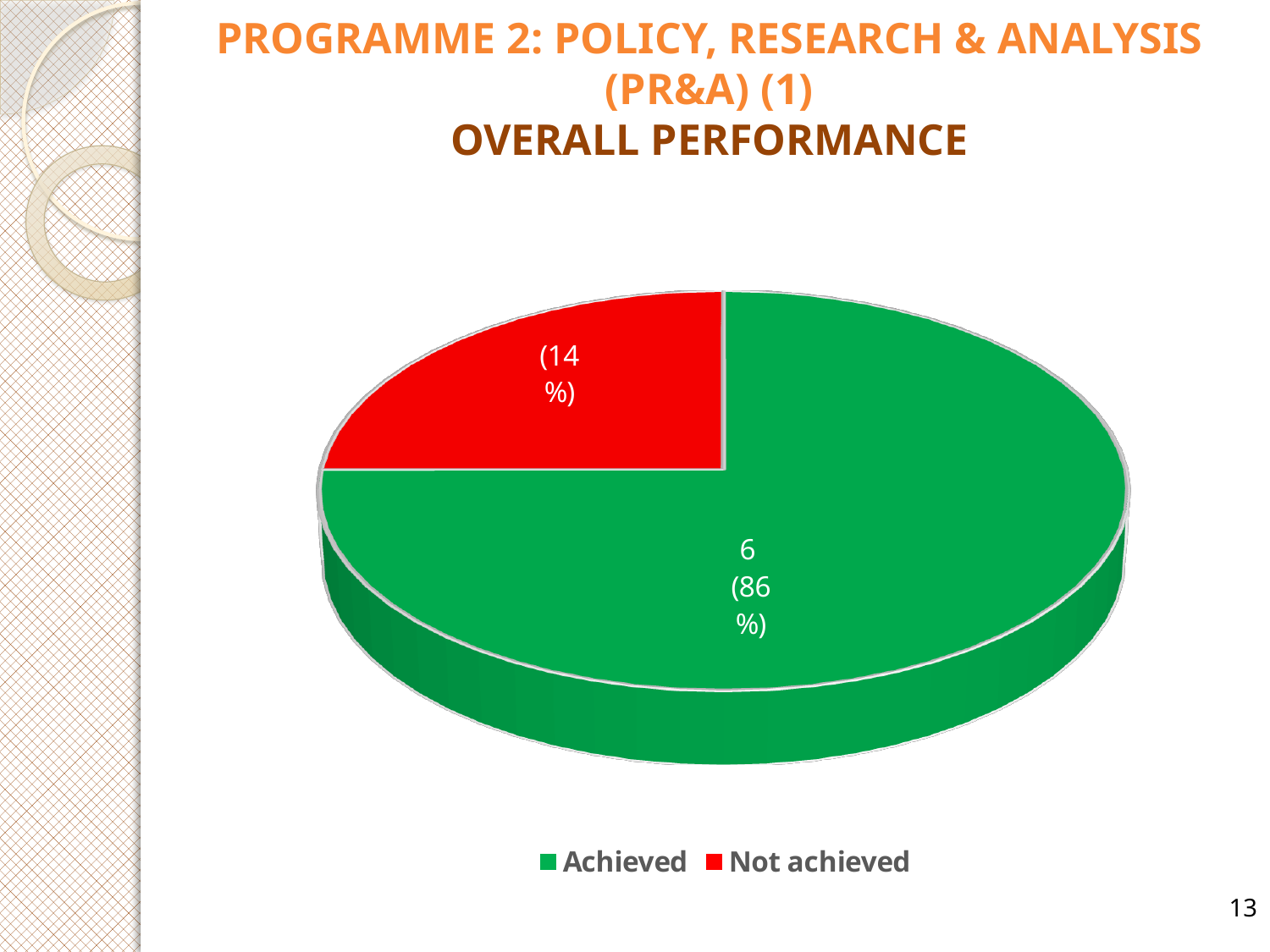
What colour is the Achieved slice? Green What kind of chart is shown on the slide? Pie chart What percentage of the pie does the Achieved slice represent? 86% What percentage of the pie does the Not achieved slice represent? 14% How many entries does the legend list? 2 What count is printed on the Achieved slice? 6 Which slice is the largest in the pie chart? Achieved What is the difference in percentage points between the Achieved and Not achieved shares? 72 Which is larger, the Achieved share or the Not achieved share? Achieved What colour is the Not achieved slice? Red Which slice is the smallest in the pie chart? Not achieved How many slices does the pie chart have? 2